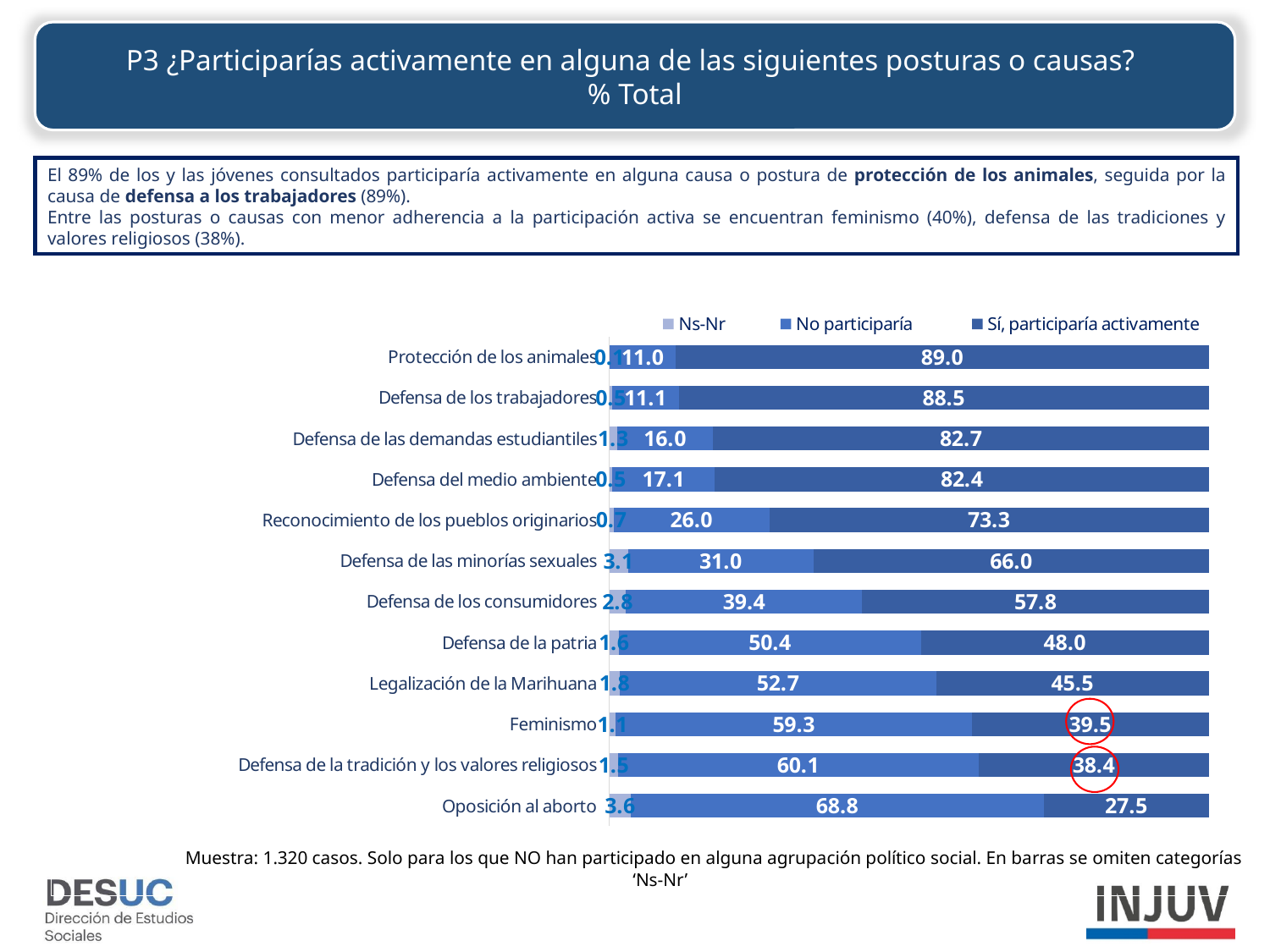
Which has a larger 'Sí, participaría activamente' value: Defensa de la patria or Legalización de la Marihuana? Defensa de la patria How many series does the legend list? 3 Which category has the lowest value for 'Sí, participaría activamente'? Oposición al aborto What kind of chart is shown on the slide? Stacked bar chart How many categories (causes) are shown in the chart? 12 What is the value of 'Sí, participaría activamente' for Protección de los animales? 89.0 What is the difference between the 'No participaría' values for Oposición al aborto and Feminismo? 9.5 What is the difference between the 'Sí, participaría activamente' values for Protección de los animales and Defensa de los trabajadores? 0.5 What is the value of 'No participaría' for Oposición al aborto? 68.8 Which category has the highest value for 'Sí, participaría activamente'? Protección de los animales Which category has the highest value for 'No participaría'? Oposición al aborto What is the value of 'No participaría' for Feminismo? 59.3